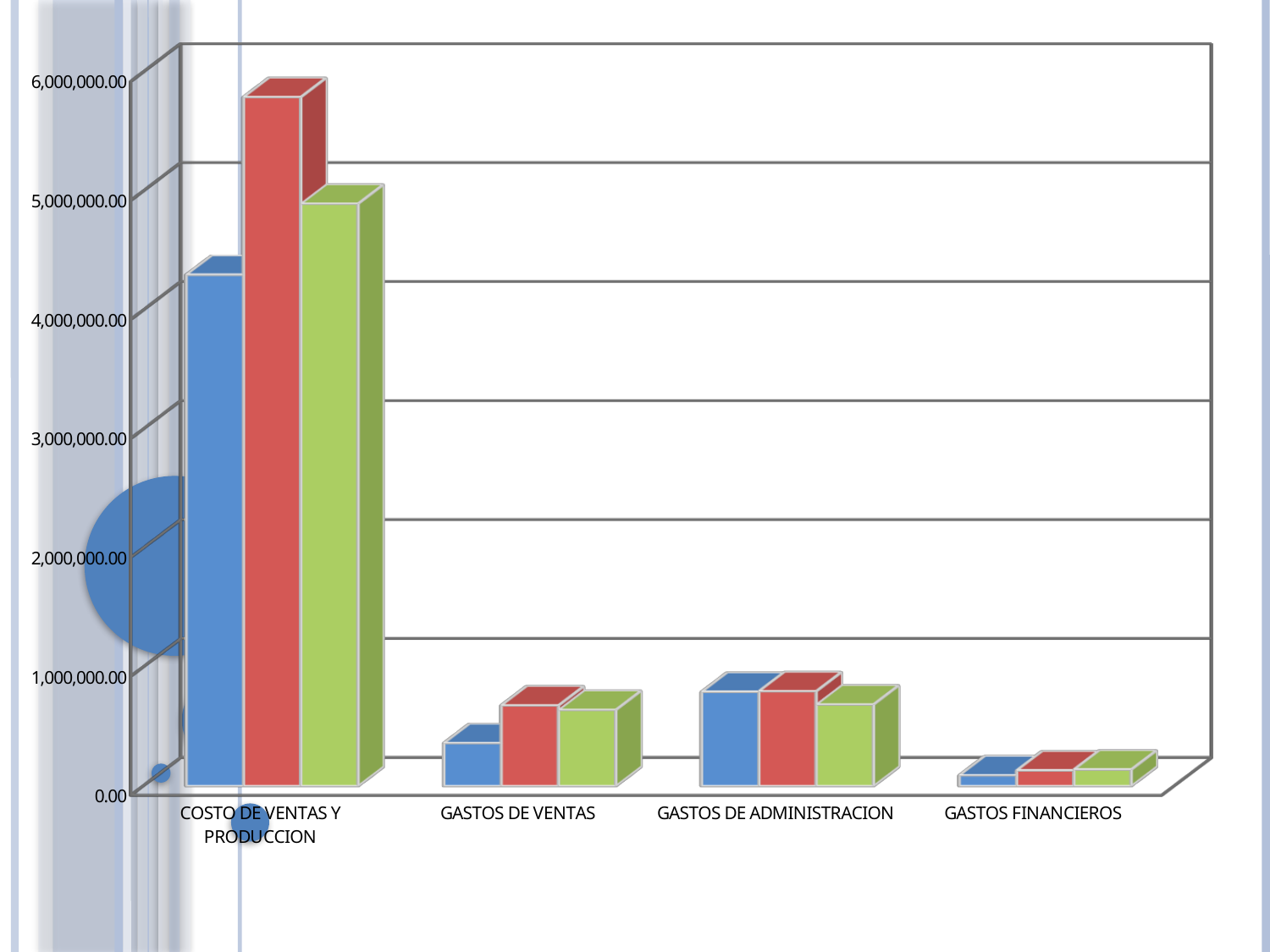
Within COSTO DE VENTAS Y PRODUCCION, which is larger, the red bar or the blue bar? The red bar Which is larger, the blue bar for GASTOS DE ADMINISTRACION or the blue bar for GASTOS DE VENTAS? GASTOS DE ADMINISTRACION What is the highest value labelled on the vertical axis of the chart? 6,000,000.00 Which category has the tallest bars in the chart? COSTO DE VENTAS Y PRODUCCION Is the value of the blue bar for GASTOS DE VENTAS greater or less than 1,000,000.00? less How many bars are shown for each category in the chart? 3 Is the value of the blue bar for COSTO DE VENTAS Y PRODUCCION greater or less than 4,000,000.00? greater Which category has the shortest bars in the chart? GASTOS FINANCIEROS Are the values for GASTOS DE ADMINISTRACION greater or less than 1,000,000.00? less What kind of chart is shown on the slide? Bar chart How many categories are shown on the x axis of the chart? 4